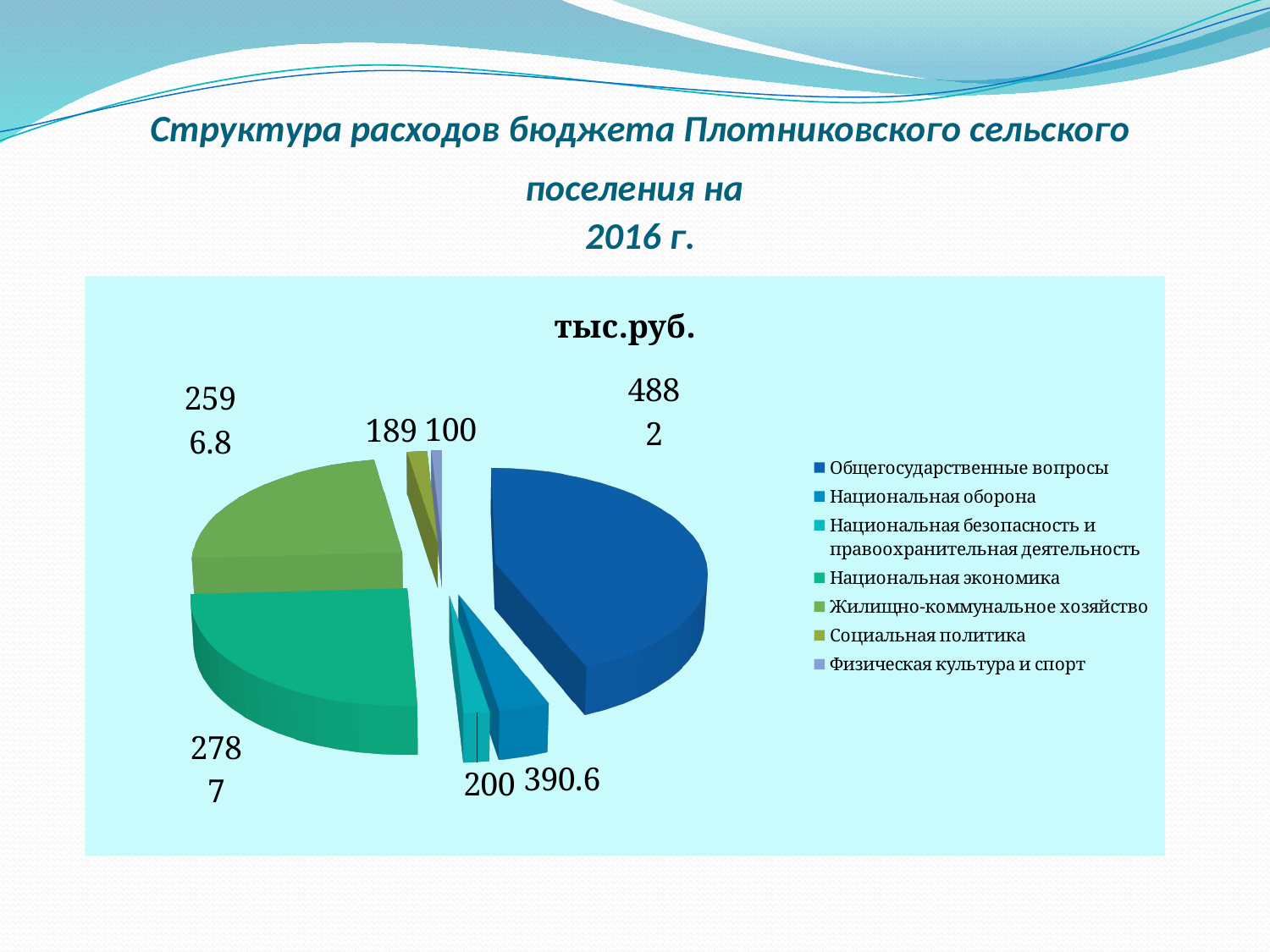
How many categories does the legend of the pie chart list? 7 What is the value for Общегосударственные вопросы? 4882 What kind of chart is shown on the slide? pie chart Which category has the largest slice of the pie? Общегосударственные вопросы Which is larger, Социальная политика or Физическая культура и спорт? Социальная политика What is the value for Социальная политика? 189 What is the value for Национальная безопасность и правоохранительная деятельность? 200 What is the difference between the values for Национальная оборона and Национальная безопасность и правоохранительная деятельность? 190.6 What is the value for Национальная оборона? 390.6 Which category has the smallest slice of the pie? Физическая культура и спорт What is the value for Физическая культура и спорт? 100 What is the title shown above the pie chart? тыс.руб.